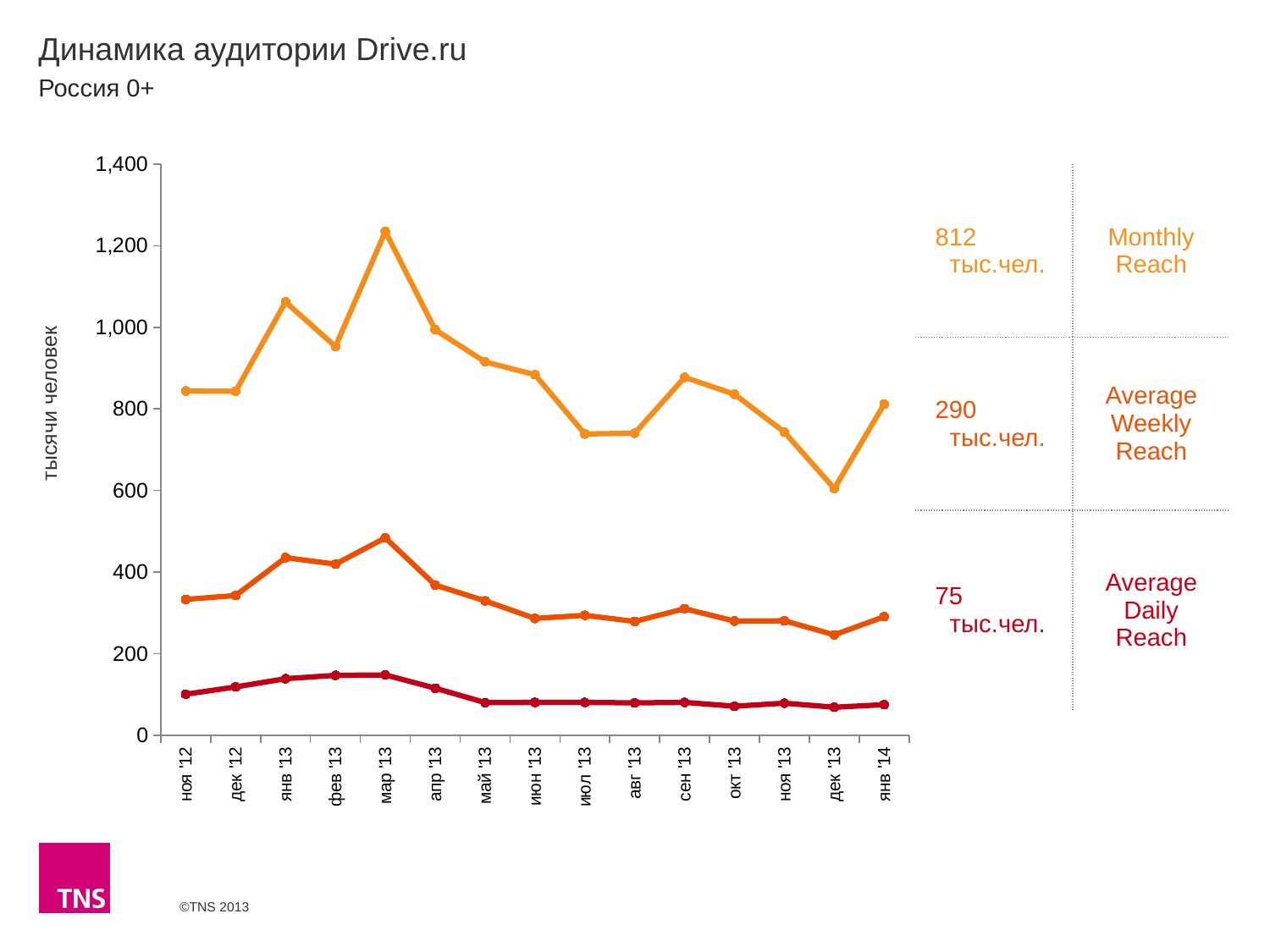
What is the difference between the Monthly Reach and the Average Weekly Reach for янв '14? 522 тыс.чел. What is the Monthly Reach value for янв '14? 812 тыс.чел. In which month is the Monthly Reach highest? мар '13 Does the Monthly Reach rise or fall from мар '13 to июл '13? fall How many months are plotted along the x axis? 15 In which month is the Monthly Reach lowest? дек '13 What is the Average Daily Reach value for янв '14? 75 тыс.чел. Is the Monthly Reach value for мар '13 greater or less than 1,200? greater What is the Average Weekly Reach value for янв '14? 290 тыс.чел. How many series are plotted on the chart? 3 What kind of chart is shown on the slide? line chart Which month has the larger Monthly Reach, янв '13 or фев '13? янв '13